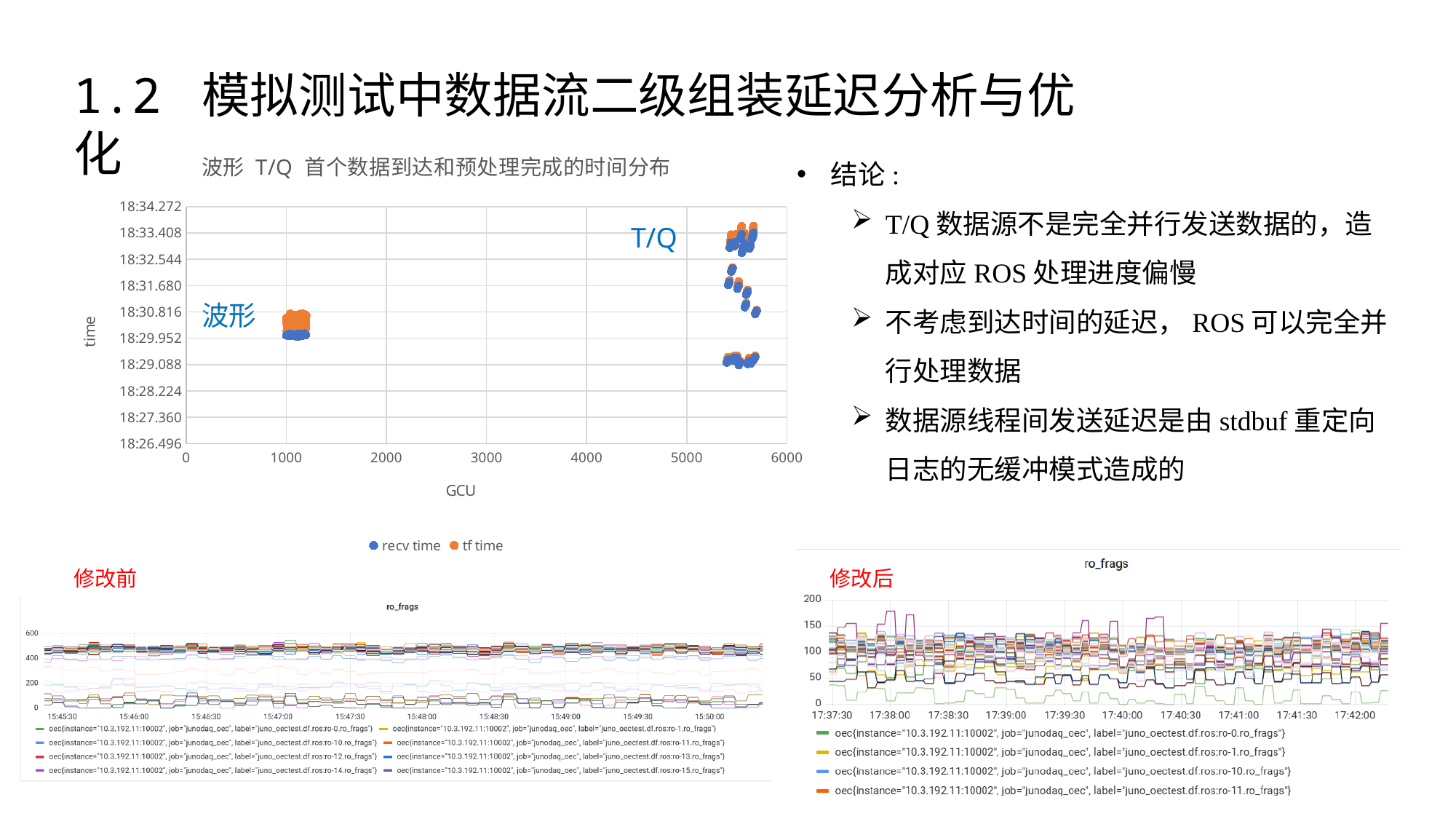
In the top-left chart '波形 T/Q 首个数据到达和预处理完成的时间分布', is the GCU value of the T/Q cluster greater or less than 5000? greater In the top-left chart '波形 T/Q 首个数据到达和预处理完成的时间分布', what are the two legend entries? recv time, tf time In the top-left chart '波形 T/Q 首个数据到达和预处理完成的时间分布', is the GCU value of the 波形 cluster greater or less than 2000? less In the bottom-right chart labelled '修改后', how many series does the legend list? 4 What kind of chart is the bottom-left chart labelled '修改前'? line chart In the top-left chart '波形 T/Q 首个数据到达和预处理完成的时间分布', how many series does the legend list? 2 What kind of chart is the bottom-right chart labelled '修改后'? line chart What is the title of the bottom-right chart labelled '修改后'? ro_frags In the top-left chart '波形 T/Q 首个数据到达和预处理完成的时间分布', is the time value of the 波形 cluster greater or less than 18:29.088? greater In the bottom-left chart labelled '修改前', how many series does the legend list? 8 What kind of chart is the top-left chart titled '波形 T/Q 首个数据到达和预处理完成的时间分布'? scatter chart